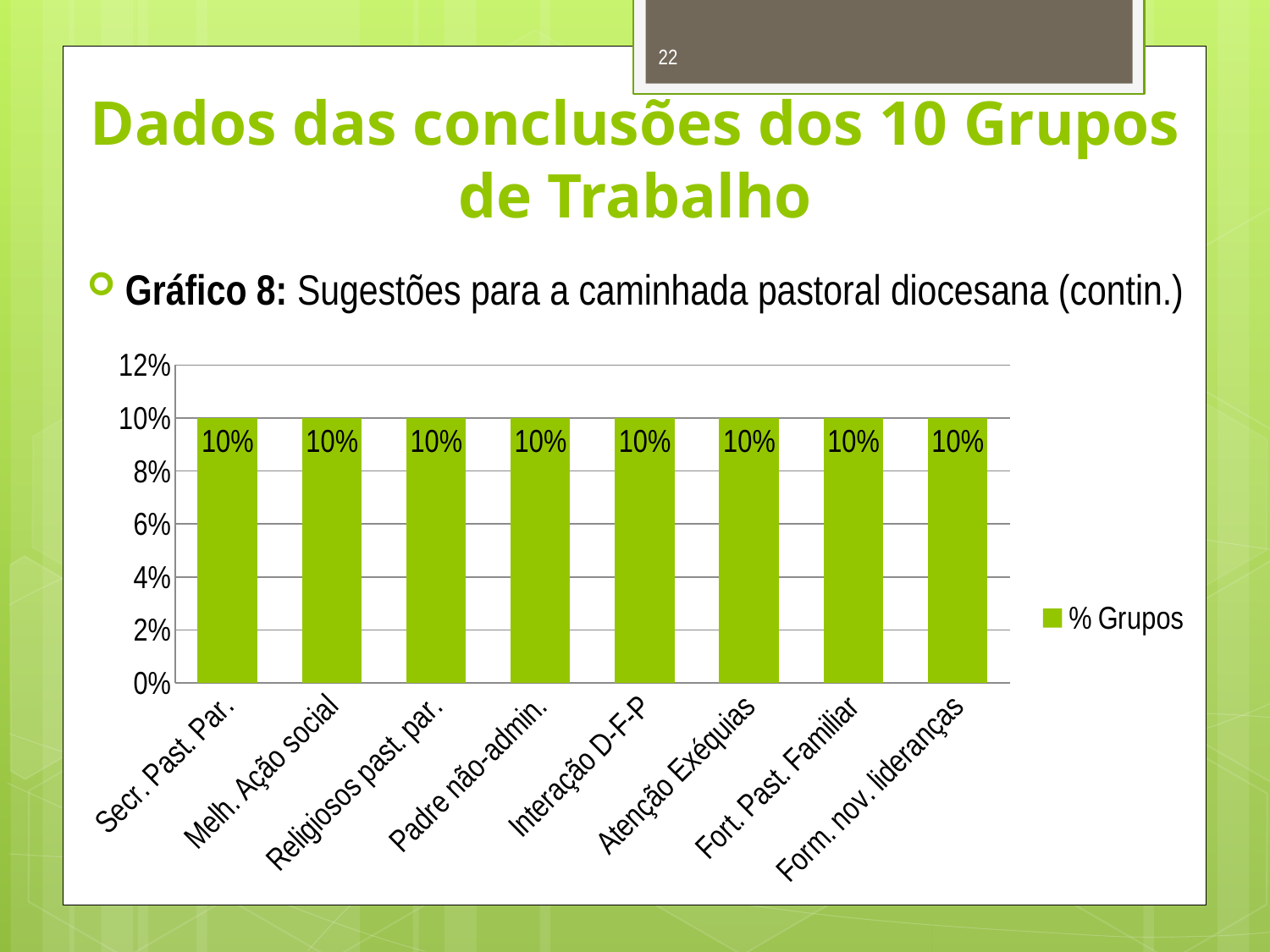
Do the values rise, fall or stay flat across the categories from left to right? stay flat What is the value for Secr. Past. Par.? 10% Is the value for Fort. Past. Familiar greater or less than 8%? greater What kind of chart is shown? bar chart What is the highest value shown on the y axis? 12% How many categories are shown on the x axis? 8 What is the difference between the values for Melh. Ação social and Interação D-F-P? 0% What is the value for Padre não-admin.? 10% What is the value for Form. nov. lideranças? 10% How many series does the legend list? 1 What is the name of the series in the legend? % Grupos What is the value for Atenção Exéquias? 10%